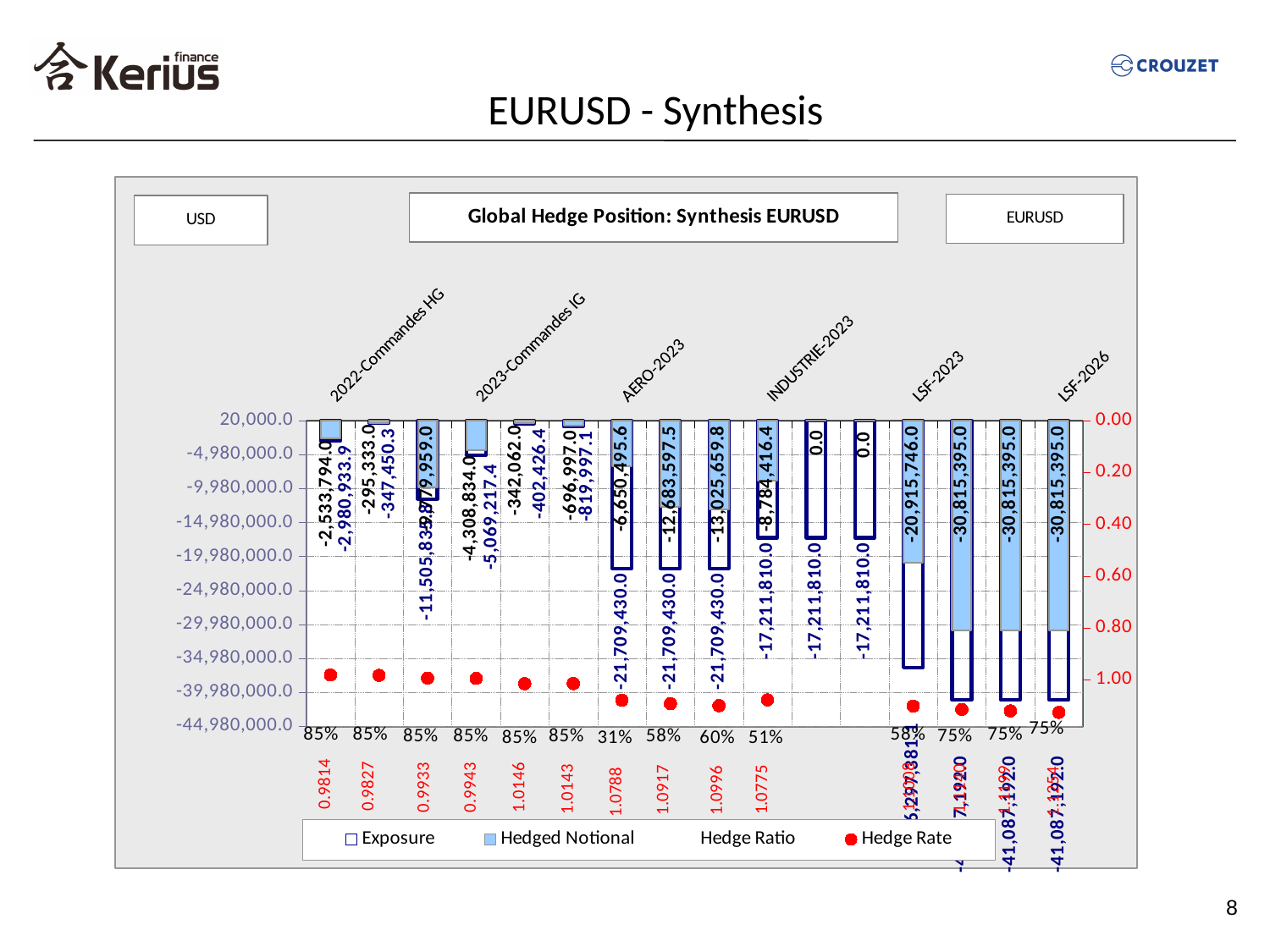
How many series does the legend of the chart list? 4 Which series is shown with red circular markers in the chart? Hedge Rate What is the title of the chart? Global Hedge Position: Synthesis EURUSD What is the Exposure value labelled on the first (leftmost) bar? -2,980,933.9 What is the Hedge Ratio printed under the first (leftmost) bar? 85% Is the Hedge Rate for the first (leftmost) bar greater or less than 1.00 on the right-hand axis? less What is the lowest Hedge Rate value printed below the chart? 0.9814 What kind of chart is shown on the slide? combination bar and line chart What is the Hedged Notional value labelled on the first (leftmost) bar? -2,533,794.0 What is the lowest Hedge Ratio percentage printed below the chart? 31% How many bars have a Hedge Ratio of 85% printed beneath them? 6 How many category labels are written along the top of the plot area? 6